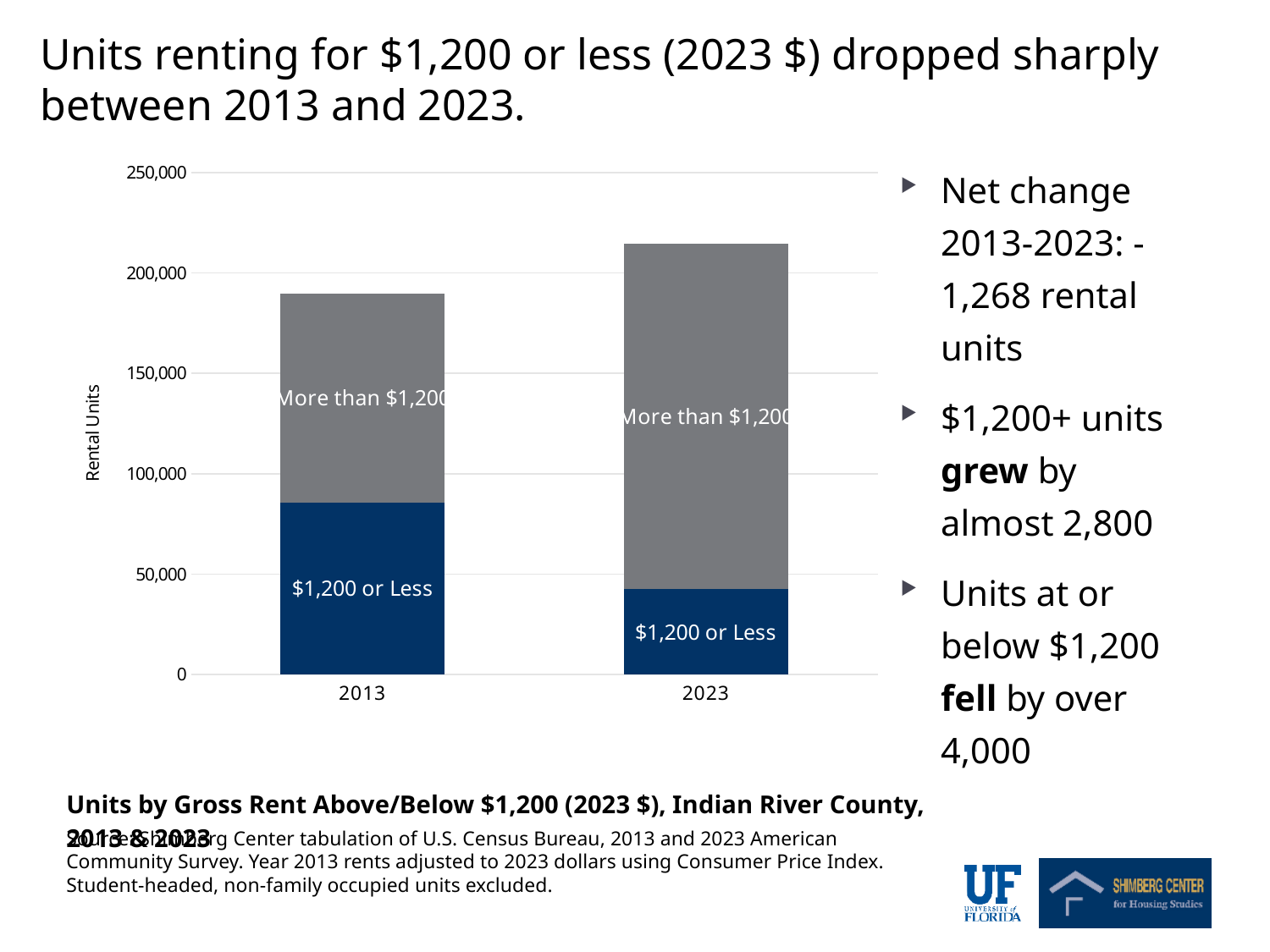
Is the "$1,200 or Less" value for 2013 greater or less than 100,000? less How many rent series are stacked in each bar of the chart? 2 What kind of chart is shown on the slide? Stacked bar chart Which year has the larger "More than $1,200" segment, 2013 or 2023? 2023 Is the total height of the 2013 bar greater or less than 200,000? less Which year has the taller total bar of rental units? 2023 Is the total height of the 2023 bar greater or less than 200,000? greater How many years (categories) are shown on the x axis of the chart? 2 What is the label on the vertical axis of the chart? Rental Units Does the "$1,200 or Less" segment rise or fall from 2013 to 2023? fall Which year has the larger "$1,200 or Less" segment, 2013 or 2023? 2013